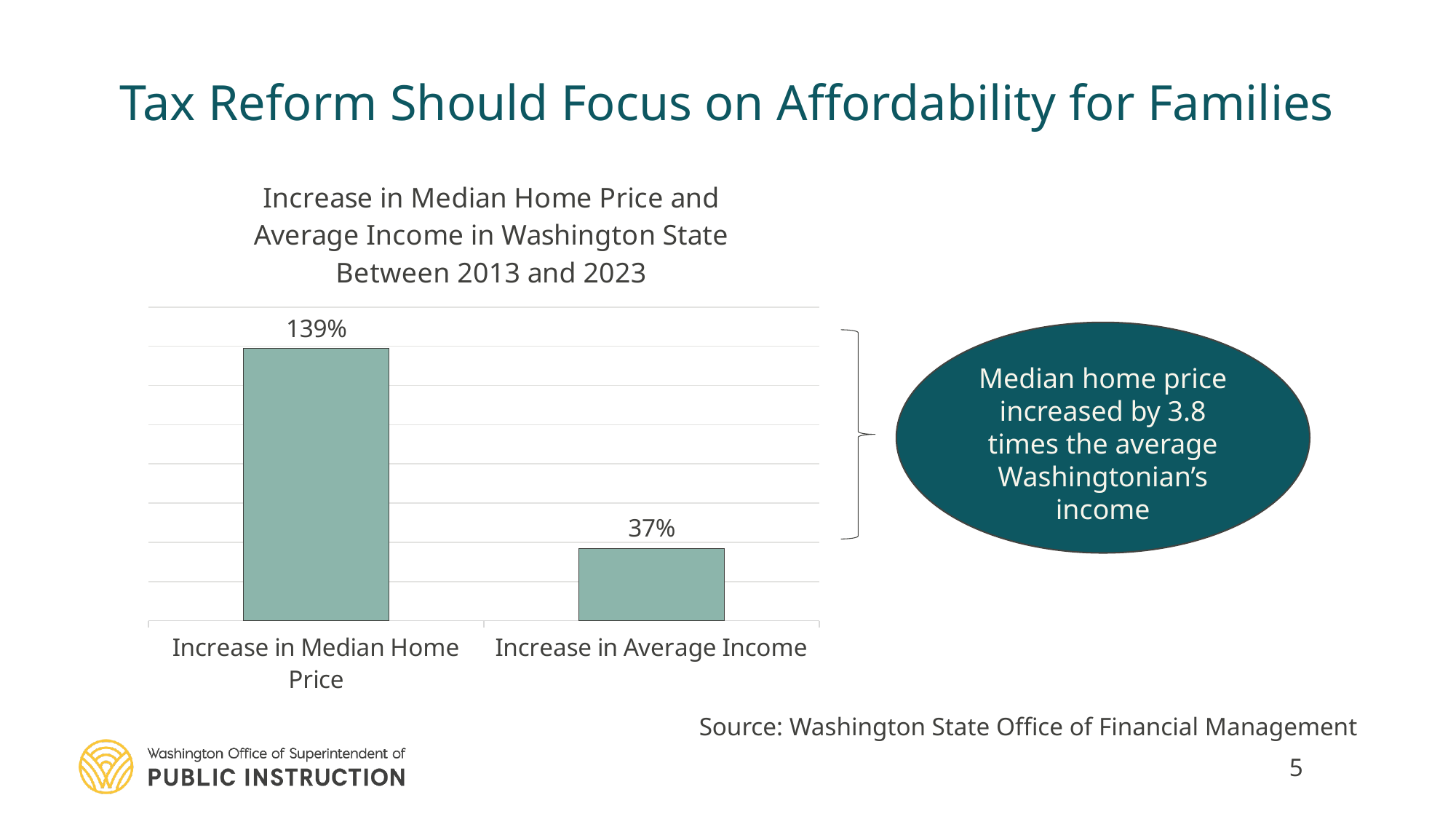
Which category has the lowest value? Increase in Average Income What is the title of the chart? Increase in Median Home Price and Average Income in Washington State Between 2013 and 2023 Which category has the highest value? Increase in Median Home Price What is the value shown for Increase in Median Home Price? 139% What kind of chart is shown on the slide? Bar chart How many categories are shown in the chart? 2 What is the value shown for Increase in Average Income? 37% What is the difference between the Increase in Median Home Price and the Increase in Average Income? 102% What source is cited for the chart data? Washington State Office of Financial Management Which is larger, the Increase in Median Home Price or the Increase in Average Income? Increase in Median Home Price